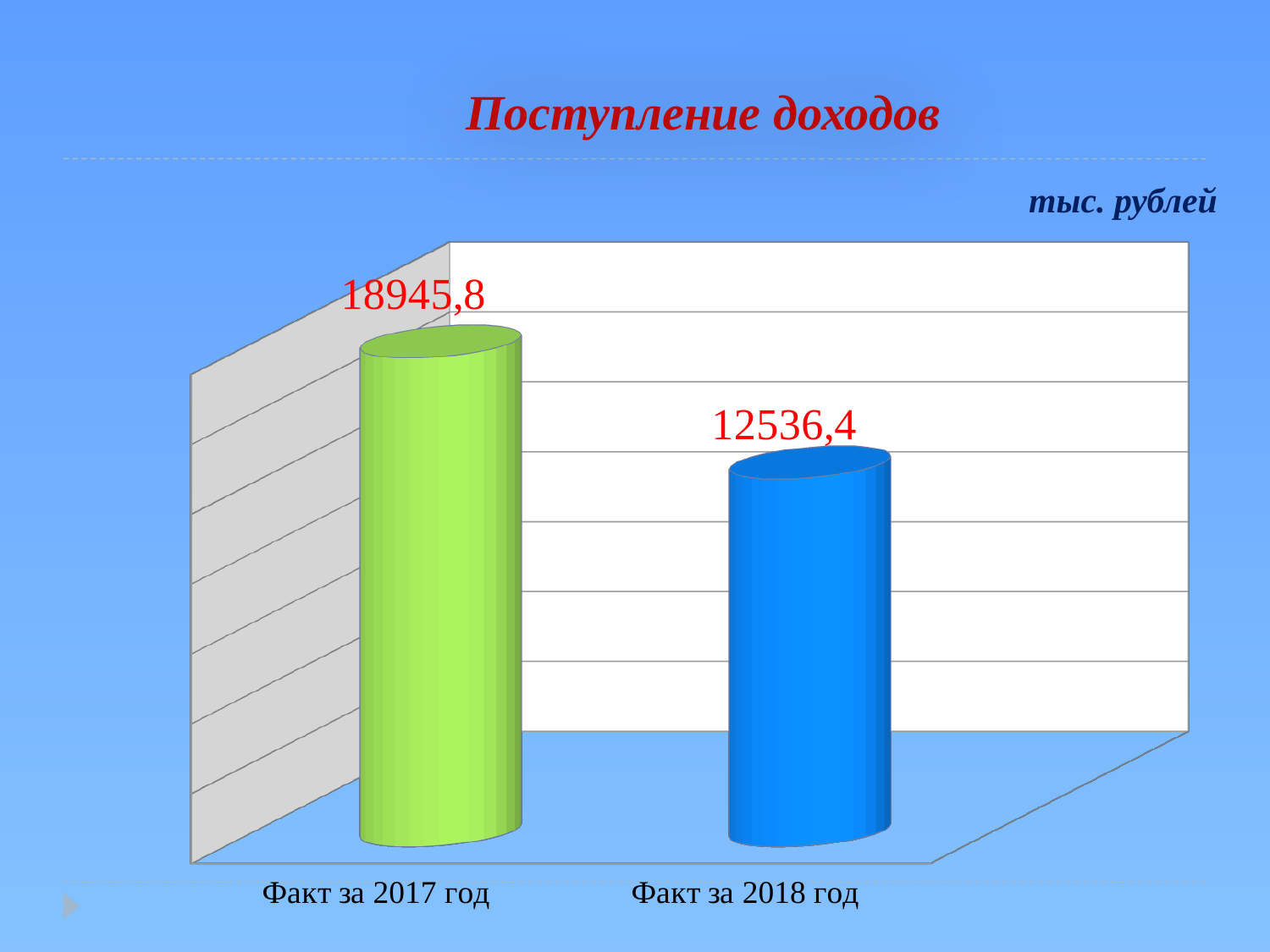
What is the value for Факт за 2018 год? 12536,4 In what units are the values on the chart given? тыс. рублей Do the values rise or fall from Факт за 2017 год to Факт за 2018 год? Fall What is the value for Факт за 2017 год? 18945,8 How many categories are shown in the chart? 2 Which category has the highest value? Факт за 2017 год Which category has the lowest value? Факт за 2018 год What is the title of the chart? Поступление доходов What kind of chart is shown on the slide? Bar chart Which is larger, the value for Факт за 2017 год or for Факт за 2018 год? Факт за 2017 год What is the difference between the values for Факт за 2017 год and Факт за 2018 год? 6409,4